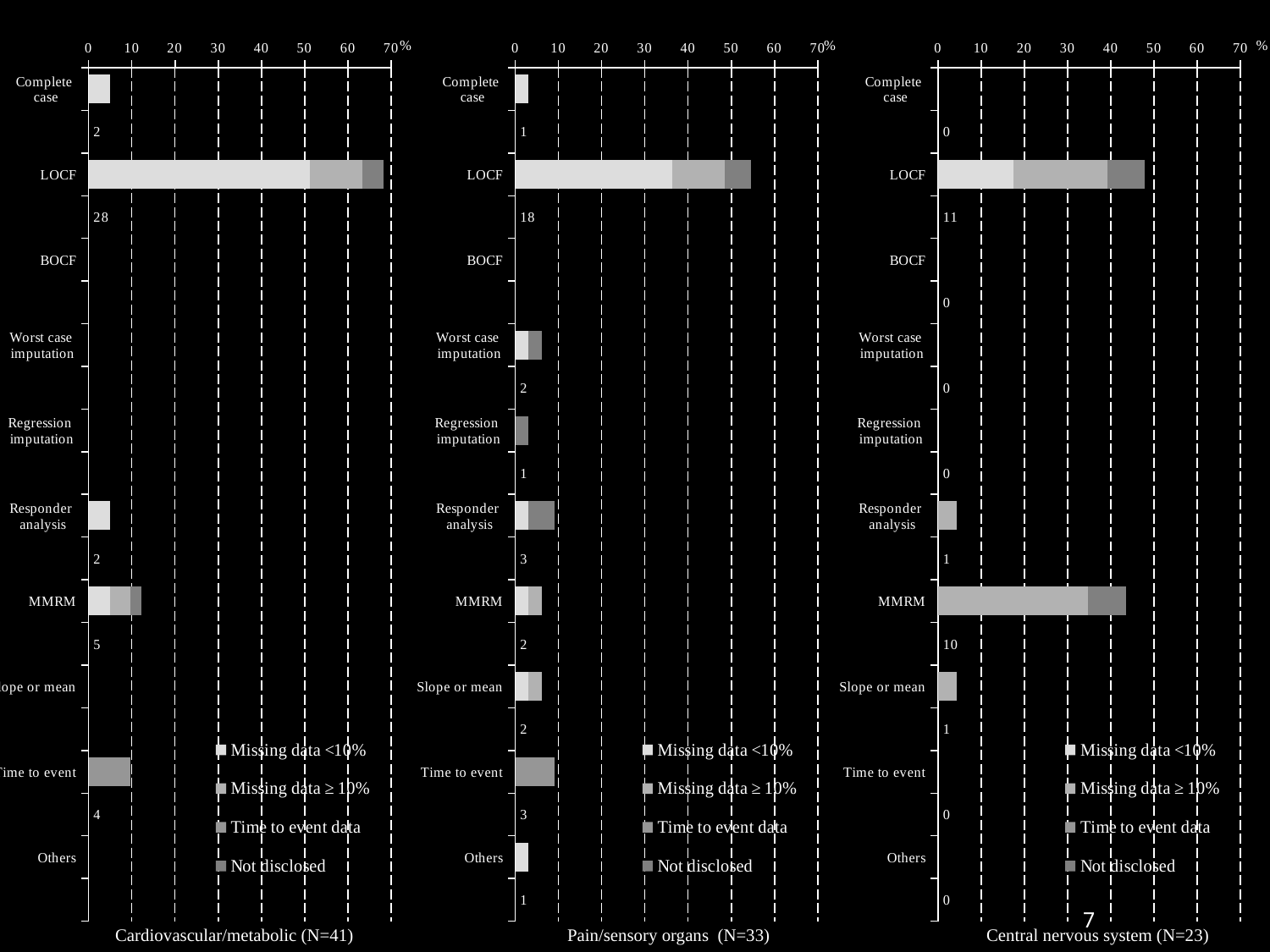
In the Pain/sensory organs (N=33) chart, which category has the longest bar? LOCF What kind of chart is the Central nervous system (N=23) chart? Stacked bar chart In the Pain/sensory organs (N=33) chart, is the total bar length for LOCF greater or less than 50? greater In the Central nervous system (N=23) chart, what number is printed for MMRM? 10 In the Cardiovascular/metabolic (N=41) chart, what is the difference between the printed numbers for LOCF and MMRM? 23 In the Cardiovascular/metabolic (N=41) chart, is the total bar length for LOCF greater or less than 60? greater How many categories are listed on the vertical axis of the Cardiovascular/metabolic (N=41) chart? 10 In the Central nervous system (N=23) chart, which category has the longest bar? LOCF In the Cardiovascular/metabolic (N=41) chart, what number is printed for LOCF? 28 How many series does the legend of the Pain/sensory organs (N=33) chart list? 4 In the Pain/sensory organs (N=33) chart, what number is printed for Responder analysis? 3 In the Central nervous system (N=23) chart, which has the larger printed number, LOCF or MMRM? LOCF